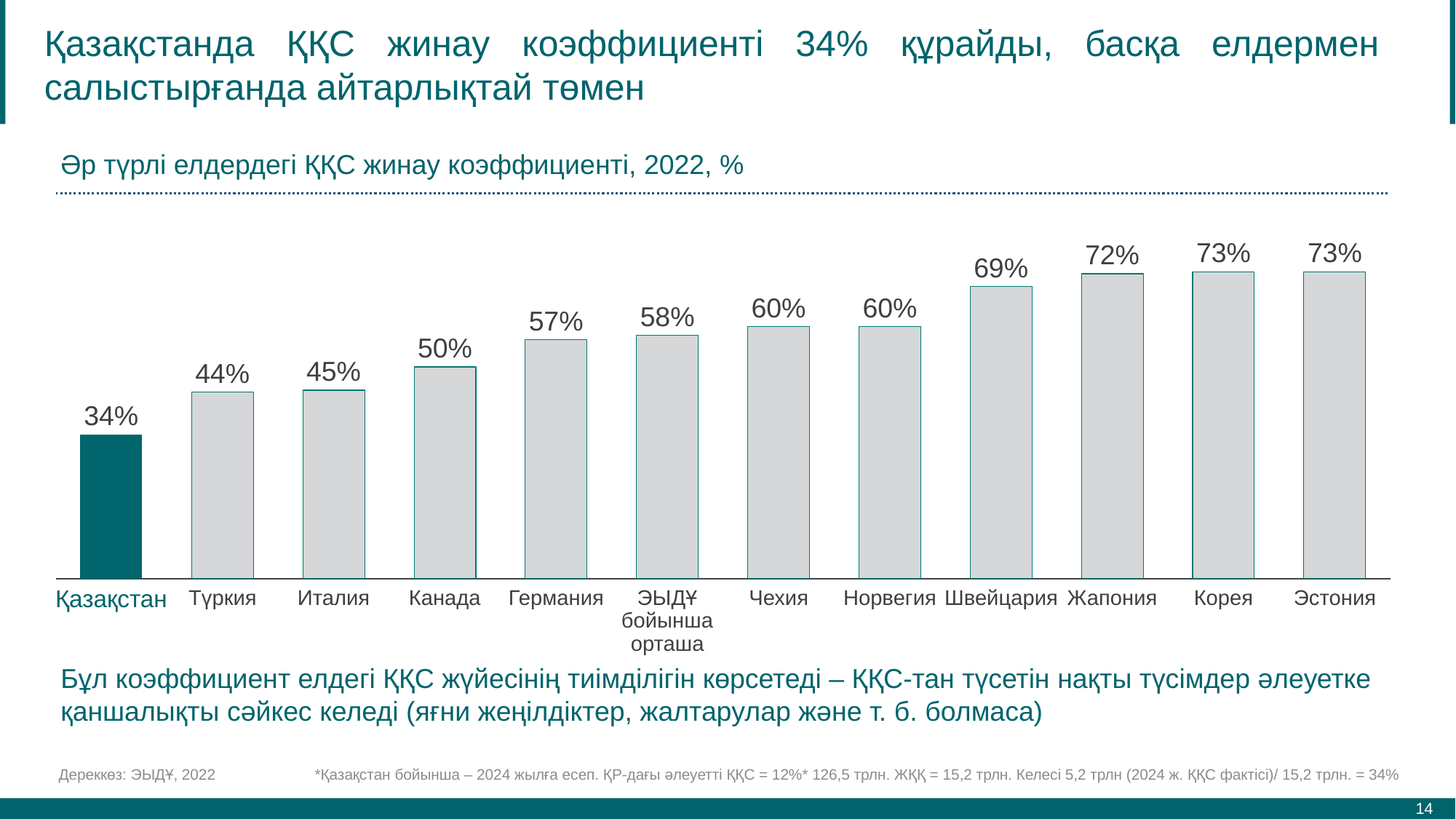
What is the value shown for Швейцария? 69% Which country has the lowest value in the chart? Қазақстан How many categories are shown in the chart? 12 What is the value shown for ЭЫДҰ бойынша орташа? 58% Do the values rise or fall from left to right along the x axis? Rise What is the title of the chart? Әр түрлі елдердегі ҚҚС жинау коэффициенті, 2022, % What type of chart is shown on the slide? Bar chart Which has a higher value, Түркия or Чехия? Чехия What is the difference between the values for Эстония and Қазақстан? 39% What is the difference between the values for Жапония and Канада? 22% What is the VAT collection coefficient for Қазақстан? 34% What is the value shown for Германия? 57%